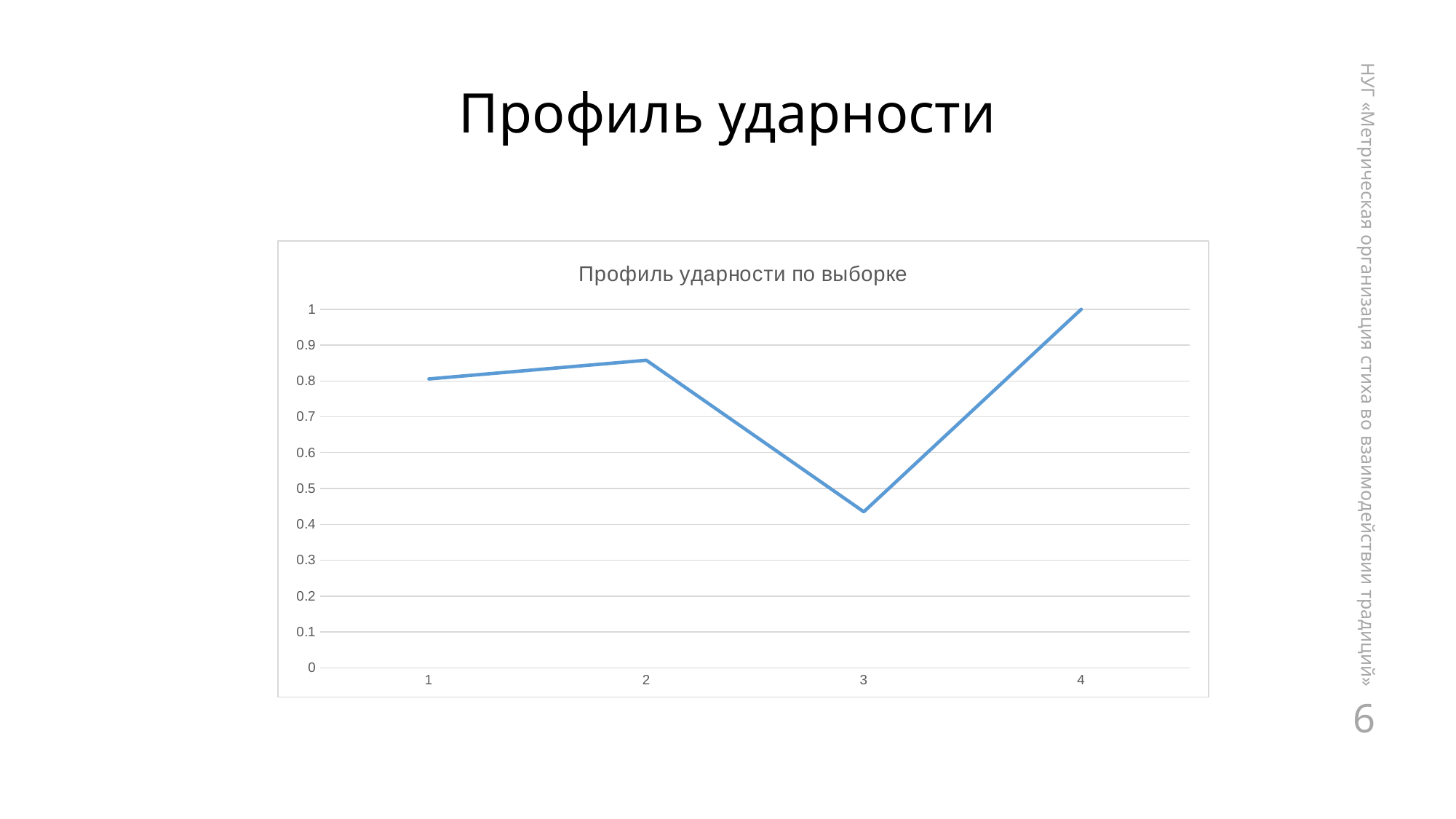
Does the line rise or fall from category 3 to category 4? rise Which is larger, the value at category 2 or the value at category 3? category 2 Which category has the lowest value? 3 What is the maximum value shown on the vertical axis? 1 Which category has the highest value? 4 What kind of chart is shown on the slide? line chart What is the title of the chart? Профиль ударности по выборке Is the value for category 2 greater or less than 0.9? less What is the value at category 4? 1 How many points are plotted on the line? 4 Is the value for category 3 greater or less than 0.5? less